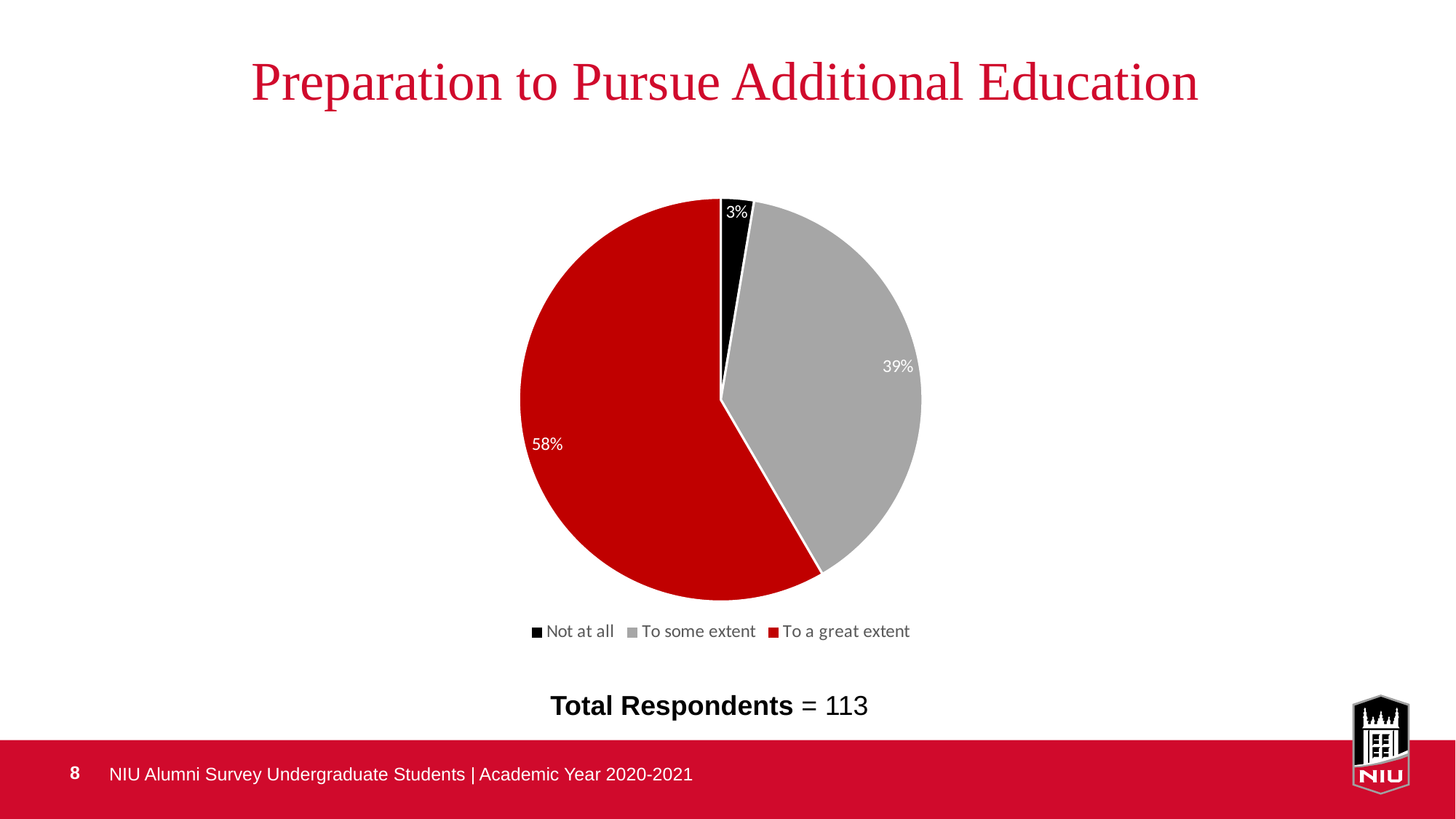
How many categories does the pie chart show? 3 What percentage of respondents answered "To a great extent"? 58% What is the difference in percentage points between "To a great extent" and "To some extent"? 19 Which response category has the largest share of the pie? To a great extent What percentage of respondents answered "To some extent"? 39% What is the combined share of "To some extent" and "To a great extent"? 97% Which is larger: the share for "To some extent" or the share for "Not at all"? To some extent What is the title of the chart on the slide? Preparation to Pursue Additional Education What type of chart is shown on the slide? pie chart What percentage of respondents answered "Not at all"? 3% Which response category has the smallest share of the pie? Not at all What colour is the slice for "To a great extent"? red